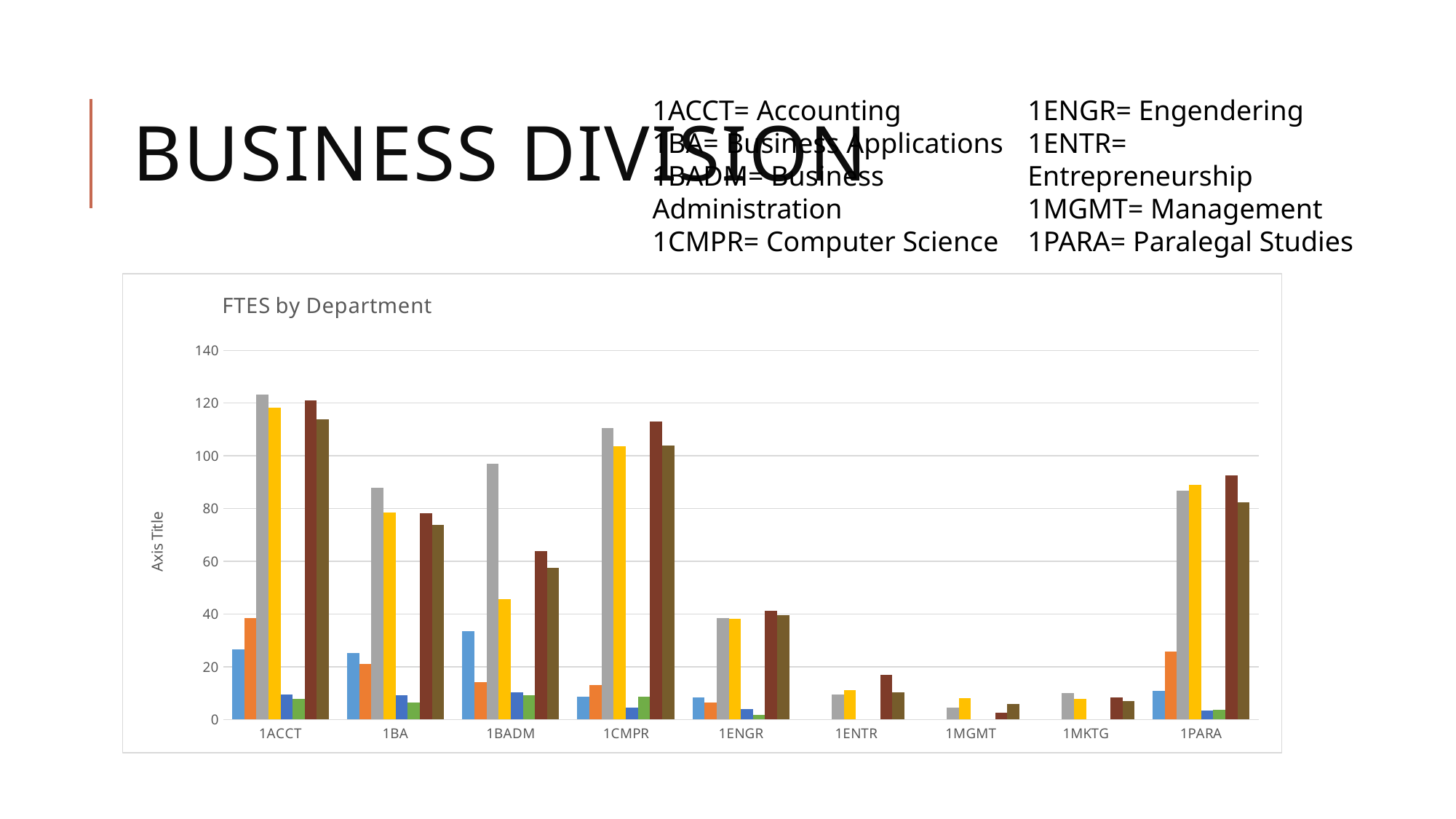
Which is larger, the yellow bar for 1BADM or the yellow bar for 1BA? the yellow bar for 1BA What kind of chart is shown on the slide? bar chart What label is shown on the vertical axis of the chart? Axis Title Which is larger, the gray bar for 1ACCT or the gray bar for 1CMPR? the gray bar for 1ACCT Is the gray bar for 1PARA greater or less than 80? greater Is the gray bar for 1BADM greater or less than 80? greater How many department categories are shown on the x axis of the chart? 9 Is the gray bar for 1ACCT greater or less than 100? greater What is the title of the chart? FTES by Department Which department category contains the tallest bar in the chart? 1ACCT